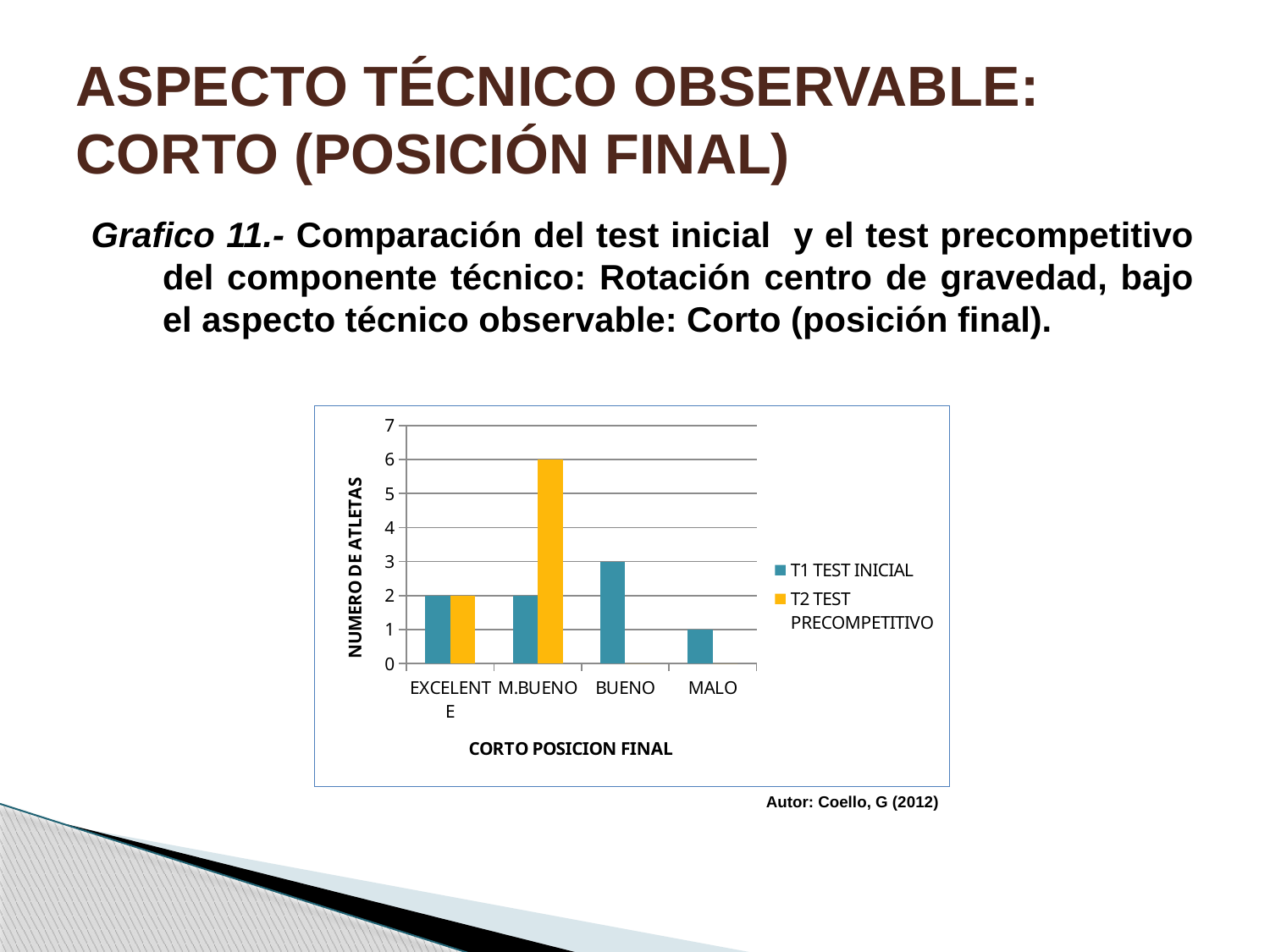
What is the value of T1 TEST INICIAL for MALO? 1 What is the label of the y axis? NUMERO DE ATLETAS How many categories are shown on the x axis? 4 What is the value of T1 TEST INICIAL for BUENO? 3 Which is larger for BUENO: T1 TEST INICIAL or T2 TEST PRECOMPETITIVO? T1 TEST INICIAL Is the value of T2 TEST PRECOMPETITIVO for M.BUENO greater or less than 4? greater What is the value of T2 TEST PRECOMPETITIVO for M.BUENO? 6 How many series does the legend list? 2 Which category has the highest value for T2 TEST PRECOMPETITIVO? M.BUENO Which category has the lowest value for T1 TEST INICIAL? MALO What is the difference between T2 TEST PRECOMPETITIVO and T1 TEST INICIAL for M.BUENO? 4 What type of chart is shown on the slide? bar chart